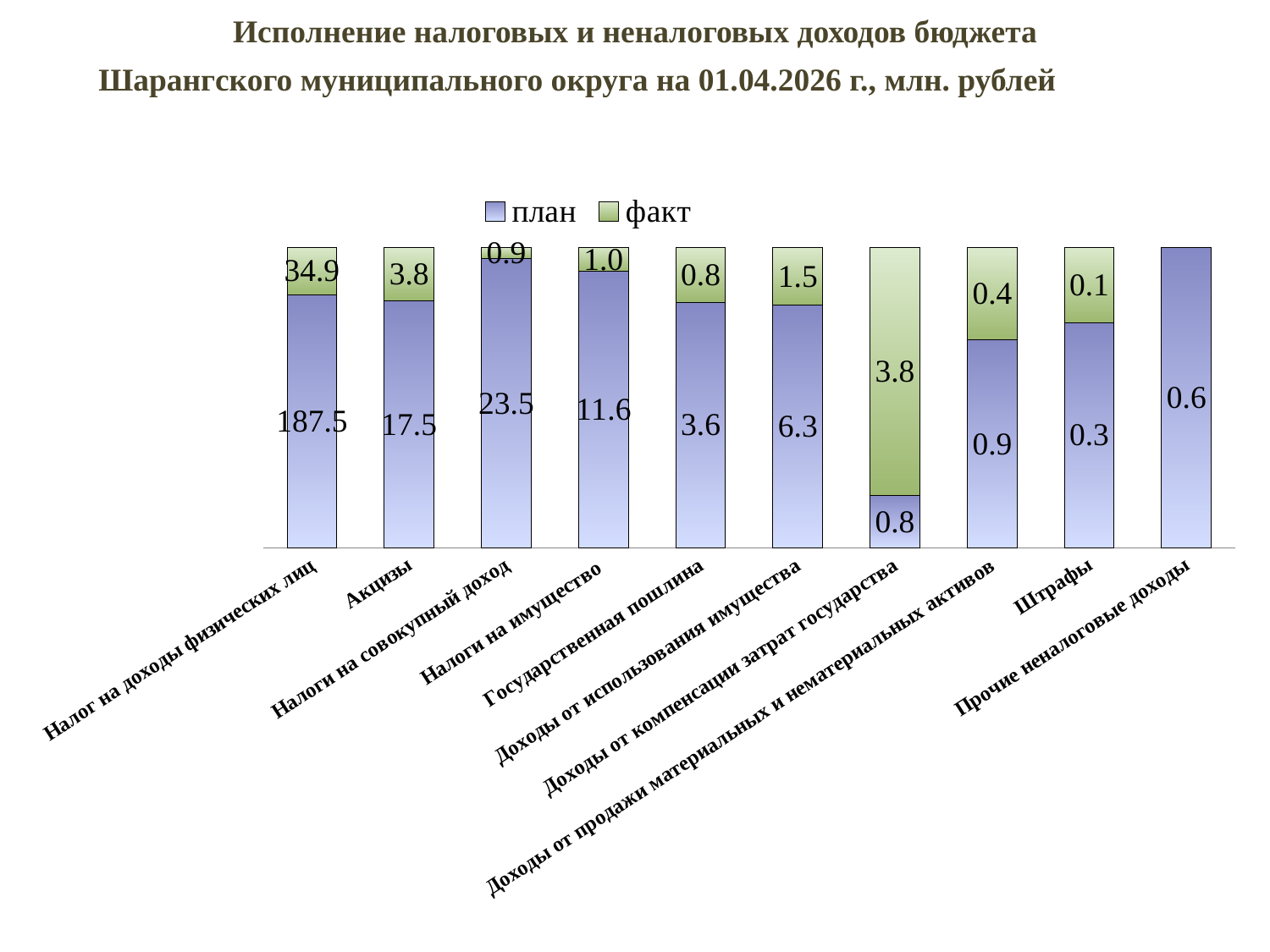
What kind of chart is shown on the slide? Bar chart What is the факт value for Акцизы? 3.8 Which is larger for Доходы от компенсации затрат государства: the план value or the факт value? факт What is the план value for Налог на доходы физических лиц? 187.5 Which is larger: the факт value for Государственная пошлина or the факт value for Доходы от использования имущества? Доходы от использования имущества Which category has the highest план value? Налог на доходы физических лиц How many categories are shown on the x axis? 10 What is the план value for Штрафы? 0.3 Which category has the lowest план value? Штрафы What is the difference between the план and факт values for Налоги на имущество? 10.6 How many series does the legend list? 2 What is the факт value for Доходы от компенсации затрат государства? 3.8